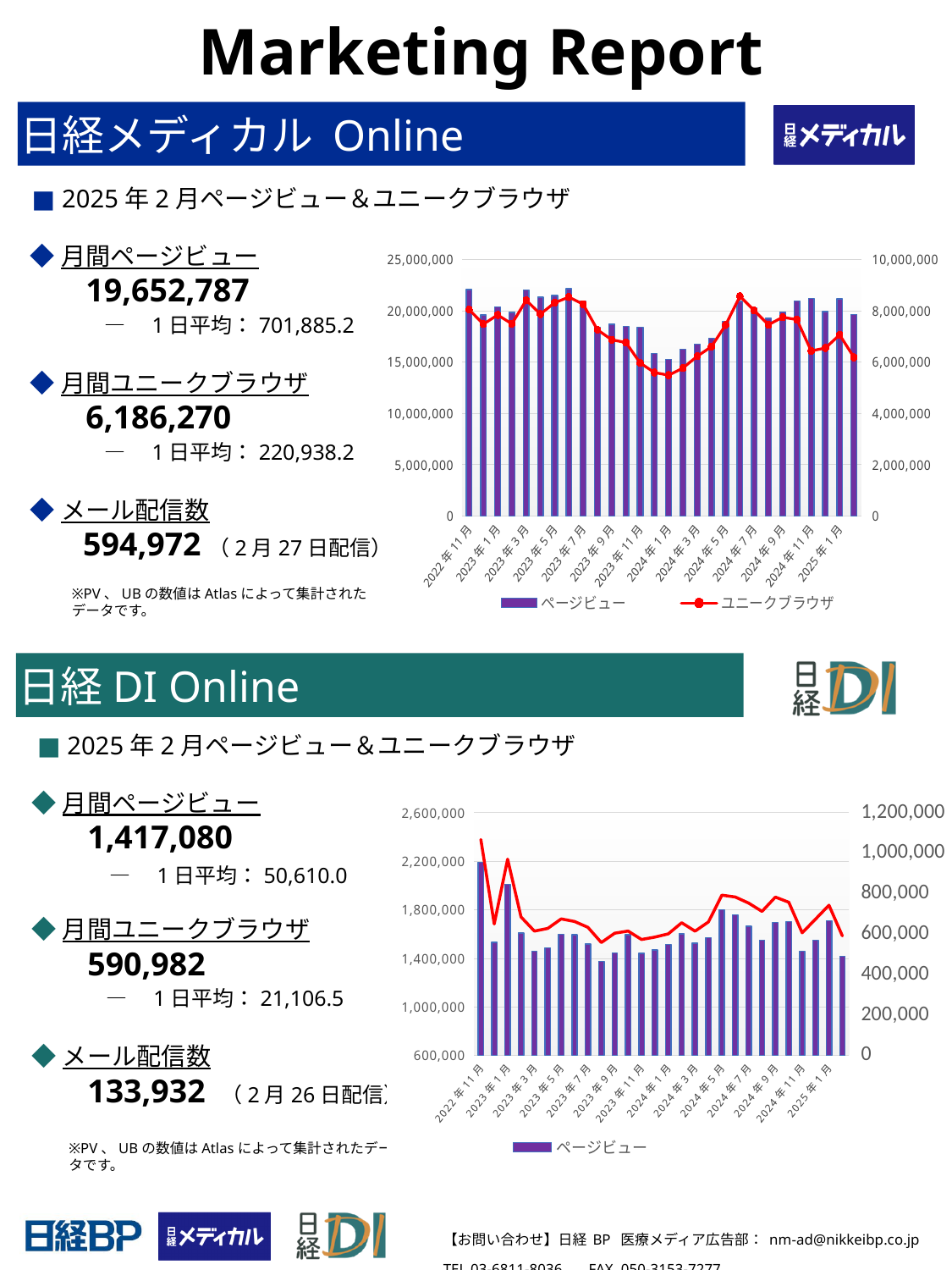
In the 日経 DI Online chart, which ページビュー bar is taller, 2022年11月 or 2023年9月? 2022年11月 In the 日経メディカル Online chart, what kind of chart is used to show ページビュー? bar chart In the 日経 DI Online chart, how many series does the legend list? 1 In the 日経メディカル Online chart, is the ページビュー bar for 2022年11月 greater or less than 20,000,000? greater In the 日経 DI Online chart, what is the highest value shown on the left axis? 2,600,000 In the 日経メディカル Online chart, what are the two legend entries? ページビュー, ユニークブラウザ In the 日経メディカル Online chart, which ページビュー bar is taller, 2022年11月 or 2024年2月? 2022年11月 In the 日経メディカル Online chart, do the ページビュー bars rise or fall from 2023年7月 to 2024年2月? fall In the 日経 DI Online chart, is the ページビュー bar for 2022年11月 greater or less than 1,800,000? greater In the 日経 DI Online chart, which month has the tallest ページビュー bar? 2022年11月 In the 日経メディカル Online chart, how many series does the legend list? 2 In the 日経メディカル Online chart, is the ユニークブラウザ value for 2024年6月 greater or less than 8,000,000 on the right axis? greater